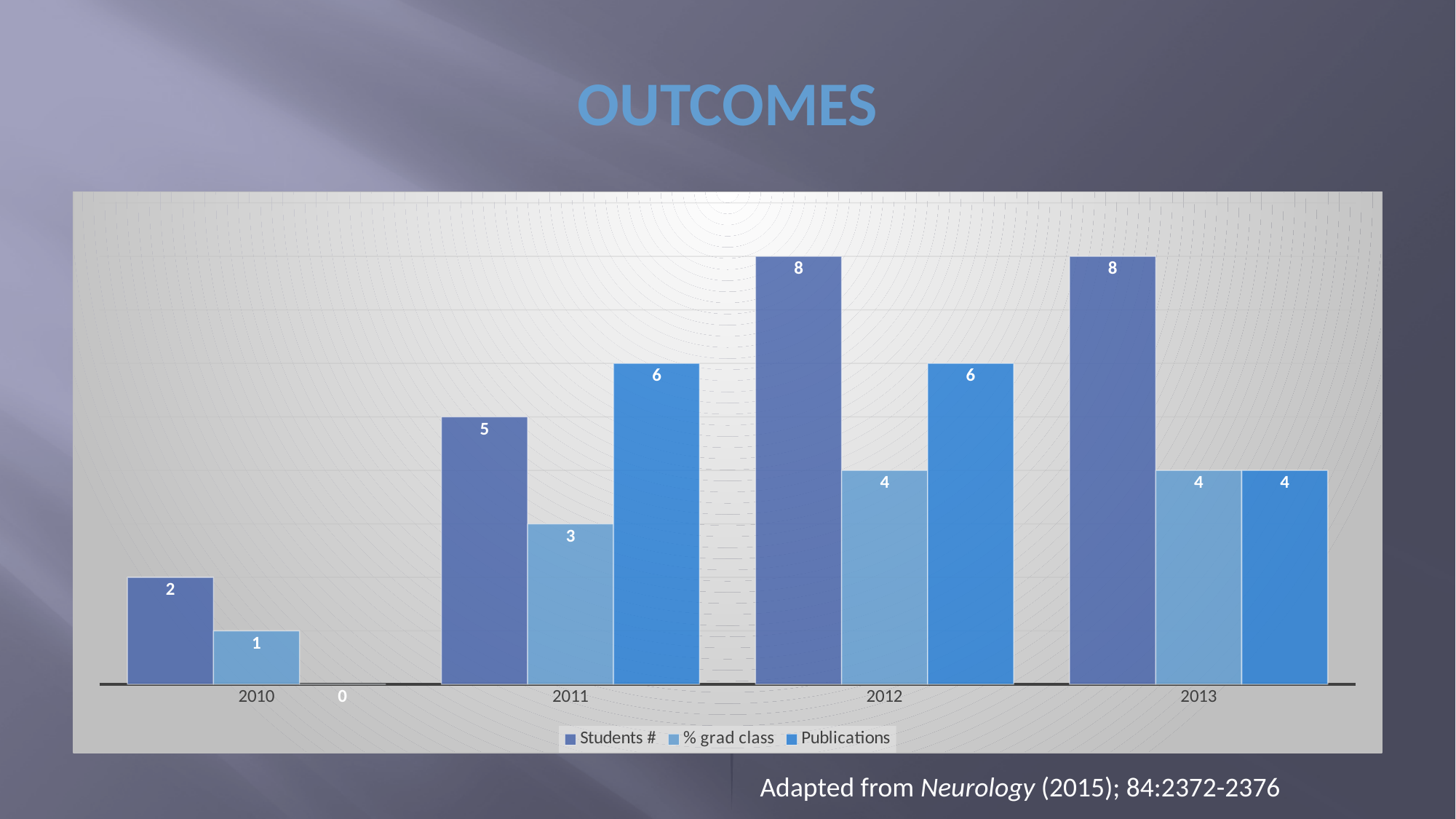
What is the value for Students # in 2012? 8 How many years are shown on the x axis? 4 Which year has the highest value for Publications? 2011 and 2012 Does the value for % grad class rise or fall from 2010 to 2012? Rise What is the value for Publications in 2011? 6 What is the difference between Students # in 2013 and Students # in 2011? 3 Which is larger, Publications in 2012 or % grad class in 2012? Publications in 2012 What is the value for Publications in 2010? 0 What is the value for % grad class in 2010? 1 Which year has the lowest value for Students #? 2010 What kind of chart is shown on the slide? Bar chart How many series does the legend list? 3